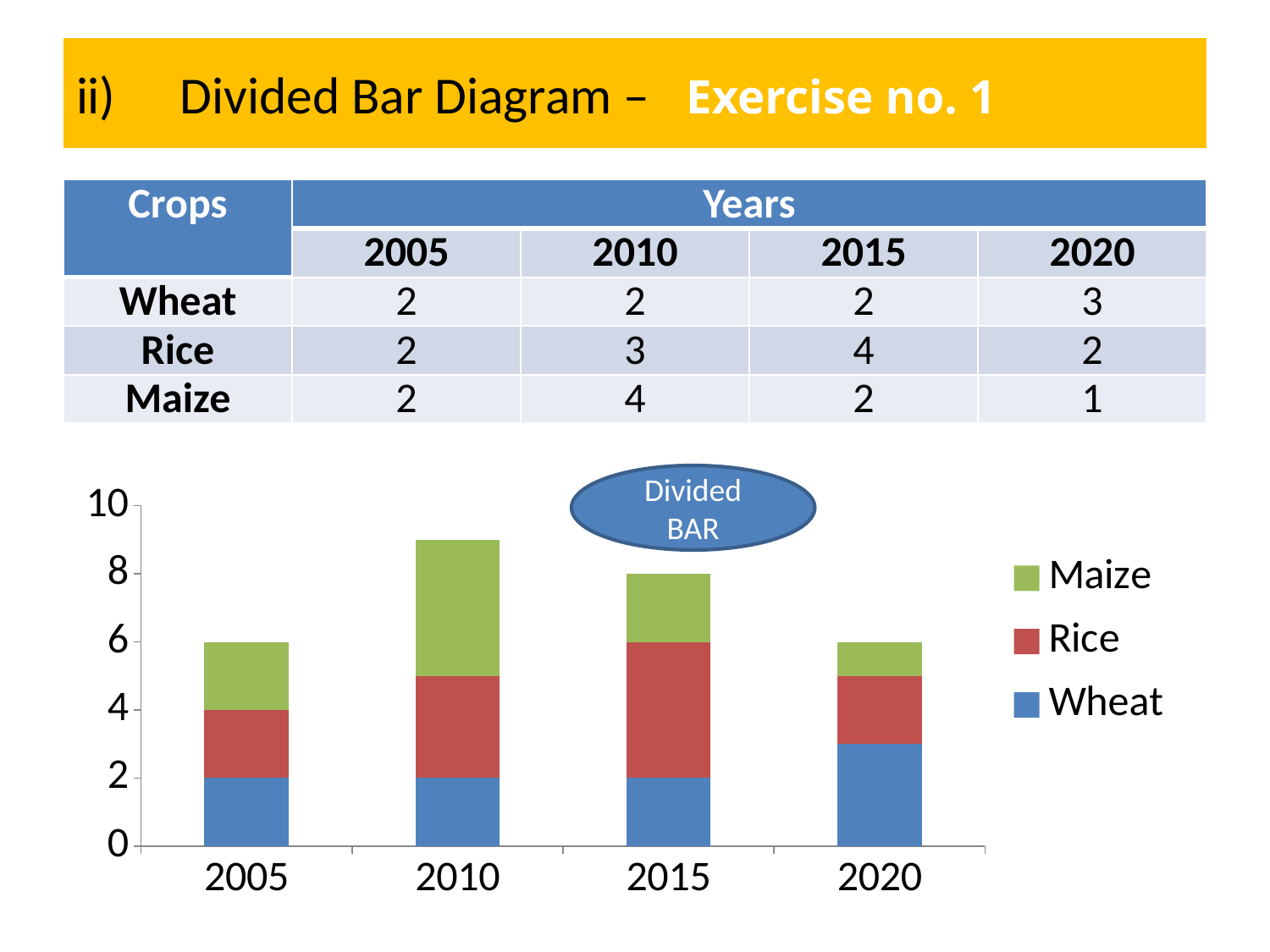
What is the value for Rice in 2015? 4 How many series does the chart legend list? 3 What kind of chart is shown on the slide? Stacked bar chart Which year has the tallest stacked bar? 2010 What is the value for Maize in 2010? 4 Which colour represents Wheat in the chart? Blue What is the total height of the stacked bar for 2015? 8 How many years are shown on the x axis of the chart? 4 What is the difference between the Maize values for 2010 and 2020? 3 What is the total height of the stacked bar for 2010? 9 What is the value for Wheat in 2020? 3 Which is larger, the Rice value in 2010 or the Rice value in 2020? Rice in 2010